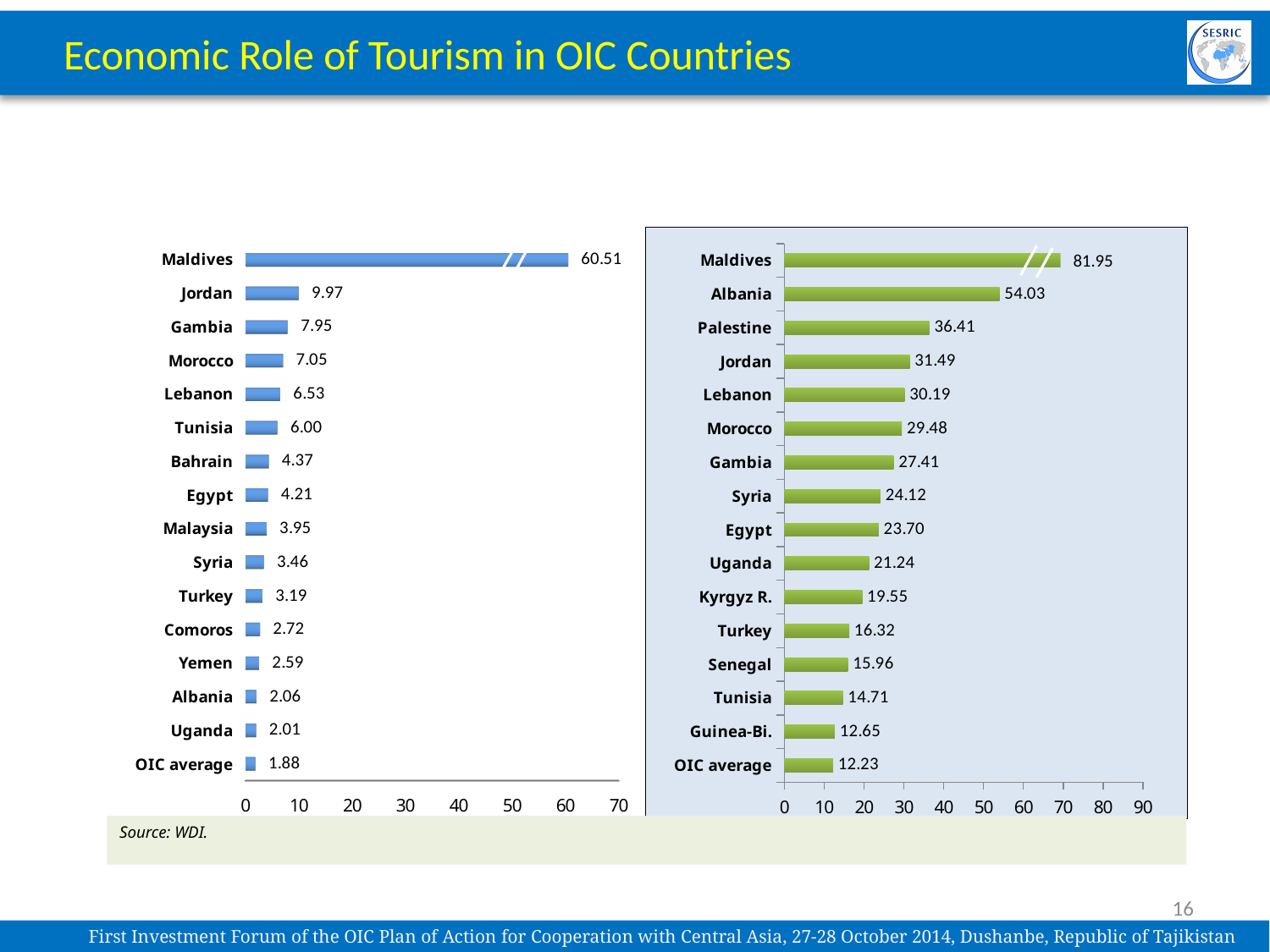
How many categories are shown in the right chart (green bars)? 16 In the left chart (blue bars), which category has the lowest value? OIC average In the right chart (green bars), which is larger, the value for Turkey or the value for Tunisia? Turkey In the right chart (green bars), what is the value for Kyrgyz R.? 19.55 In the left chart (blue bars), what is the value for Jordan? 9.97 In the right chart (green bars), what is the difference between the values for Albania and Jordan? 22.54 In the left chart (blue bars), what is the value for OIC average? 1.88 In the left chart (blue bars), is the value for Maldives greater or less than 50? greater In the right chart (green bars), which category has the highest value? Maldives In the left chart (blue bars), what is the difference between the values for Gambia and Morocco? 0.90 In the right chart (green bars), what is the value for Palestine? 36.41 What kind of chart is the left chart (blue bars)? Bar chart